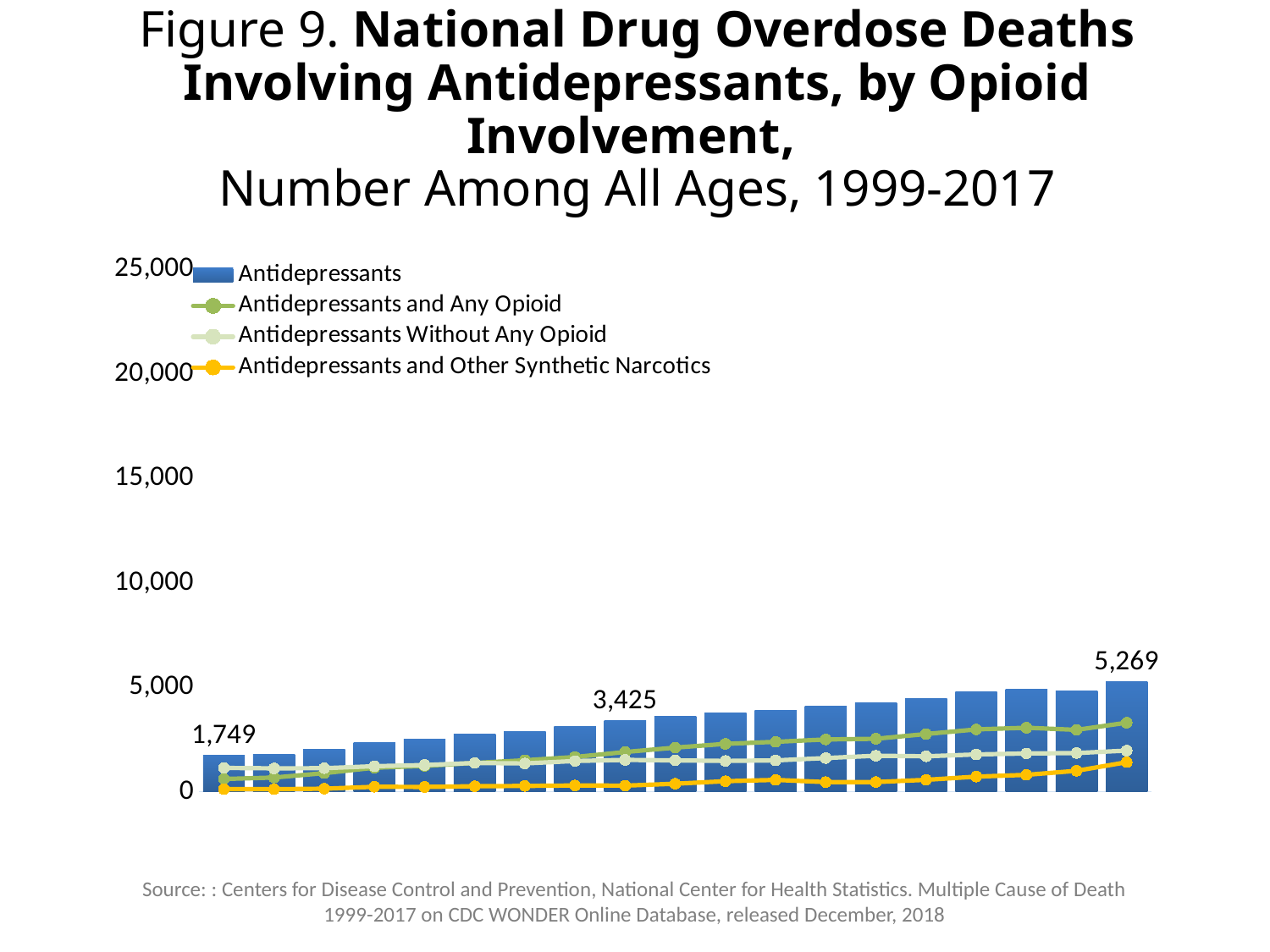
Which Antidepressants bar is the highest? the last (rightmost) bar, 5,269 Do the Antidepressants bars generally rise or fall from left to right? rise What is the difference between the last Antidepressants bar (5,269) and the first Antidepressants bar (1,749)? 3,520 How many bars are plotted in the chart? 19 What is the difference between the last Antidepressants bar (5,269) and the bar labelled 3,425? 1,844 Is the final value of the Antidepressants and Any Opioid line greater or less than 5,000? less What is the value printed on the last (rightmost) Antidepressants bar? 5,269 How many series does the legend list? 4 At the rightmost point, which line is higher: Antidepressants and Any Opioid or Antidepressants and Other Synthetic Narcotics? Antidepressants and Any Opioid What is the value printed on the first (leftmost) Antidepressants bar? 1,749 What kind of chart is shown on the slide? bar chart with line series